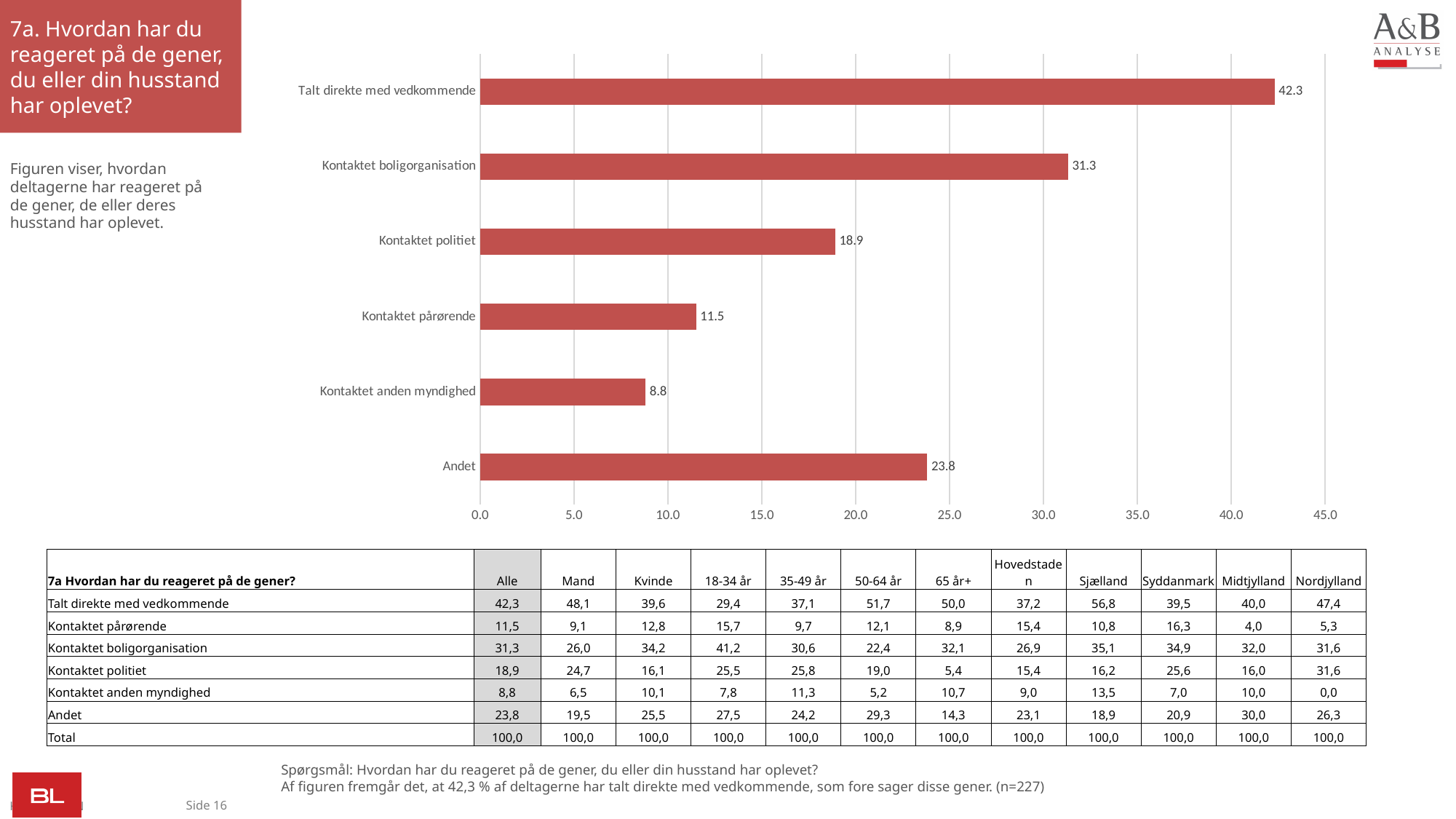
Is the value for "Kontaktet pårørende" greater or less than 15.0? less Which is larger, the value for "Kontaktet politiet" or the value for "Andet"? Andet What is the highest value shown on the x axis of the chart? 45.0 What value is shown for "Talt direkte med vedkommende"? 42.3 What is the difference between the values for "Talt direkte med vedkommende" and "Kontaktet boligorganisation"? 11.0 What value is shown for "Kontaktet anden myndighed"? 8.8 What value is shown for "Andet"? 23.8 Which category has the highest value? Talt direkte med vedkommende How many categories are shown in the chart? 6 Which category has the lowest value? Kontaktet anden myndighed What value is shown for "Kontaktet boligorganisation"? 31.3 What kind of chart is shown on the slide? Bar chart